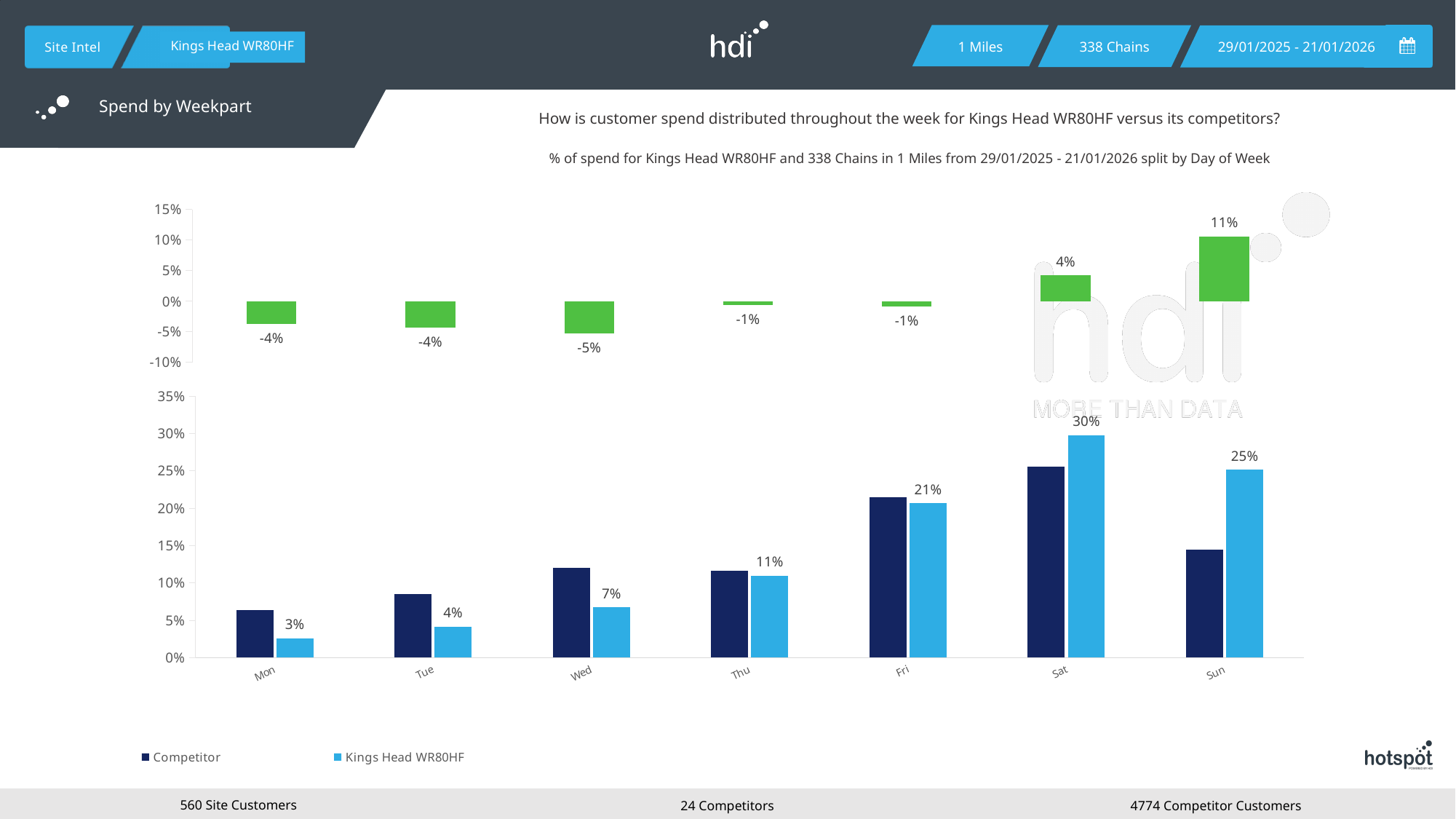
In the bottom chart, is the Competitor value for Sat greater or less than 20%? greater What type of chart is the bottom chart? Bar chart In the top chart, what is the value shown for Wed? -5% In the bottom chart, what is the value for Kings Head WR80HF on Sat? 30% In the top chart, what is the value shown for Sun? 11% In the bottom chart, on which day is the Kings Head WR80HF value highest? Sat In the bottom chart, what is the value for Kings Head WR80HF on Mon? 3% How many series does the legend of the bottom chart list? 2 In the top chart, which day has the lowest value? Wed In the bottom chart, on Sun, which is larger: the Competitor bar or the Kings Head WR80HF bar? Kings Head WR80HF How many days of the week are shown on the x axis of the bottom chart? 7 In the bottom chart, what is the difference between the Kings Head WR80HF values for Sat and Sun? 5%